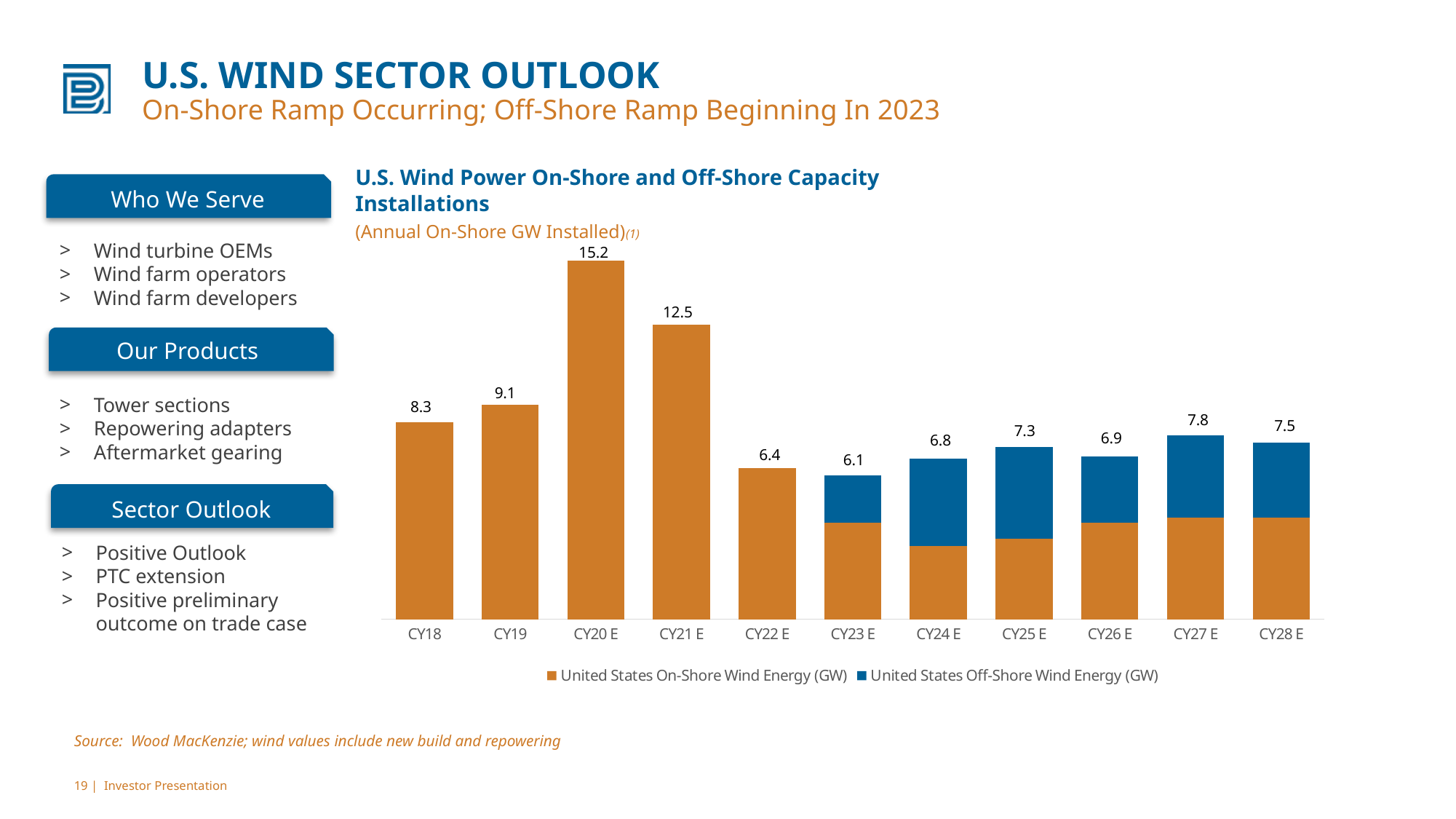
What is the difference between the total labelled values for CY20 E and CY21 E? 2.7 Which year has the highest total labelled value? CY20 E What is the total labelled value for CY28 E? 7.5 Which year has the lowest total labelled value? CY23 E Do the total labelled values rise or fall from CY19 to CY20 E? Rise Which is larger, the total labelled value for CY19 or for CY22 E? CY19 How many years are shown on the x axis? 11 What is the total labelled value for CY18? 8.3 What kind of chart is shown? Stacked bar chart How many series does the legend list? 2 What is the total labelled value for CY20 E? 15.2 Which colour represents United States Off-Shore Wind Energy (GW) in the legend? Blue